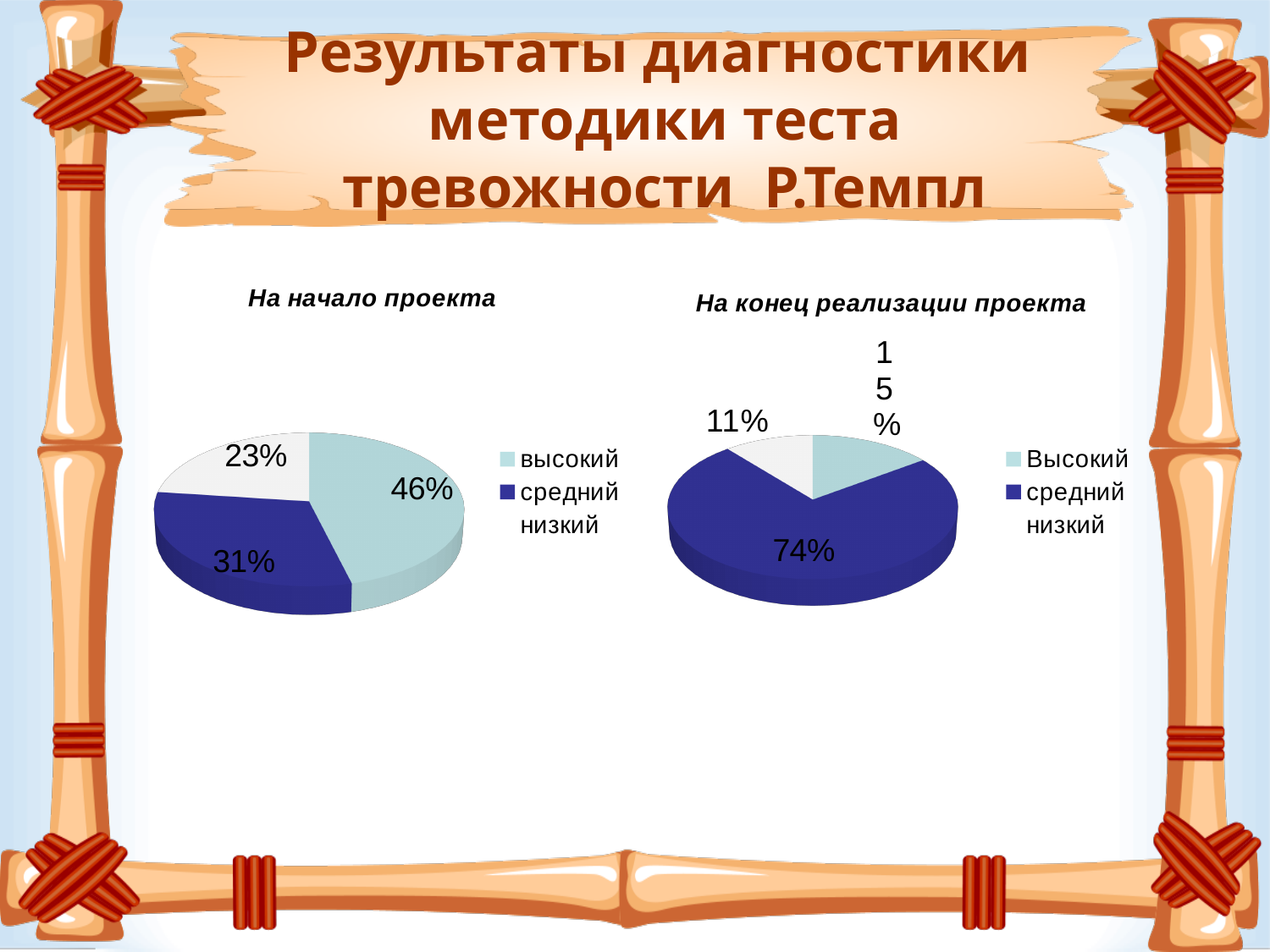
In the chart titled 'На конец реализации проекта', which category has the smallest share? низкий What type of chart is the one titled 'На начало проекта'? pie chart In the chart titled 'На конец реализации проекта', what is the difference between the 'средний' and 'Высокий' shares? 59% In the chart titled 'На начало проекта', which is larger: 'средний' or 'низкий'? средний In the chart titled 'На начало проекта', what is the value for 'высокий'? 46% In the chart titled 'На конец реализации проекта', what is the value for 'средний'? 74% In the chart titled 'На конец реализации проекта', what is the value for 'Высокий'? 15% How many series does the legend of the chart titled 'На конец реализации проекта' list? 3 In the chart titled 'На конец реализации проекта', what is the value for 'низкий'? 11% In the chart titled 'На начало проекта', what is the value for 'низкий'? 23% In the chart titled 'На начало проекта', which category has the largest share? высокий In the chart titled 'На начало проекта', what is the value for 'средний'? 31%